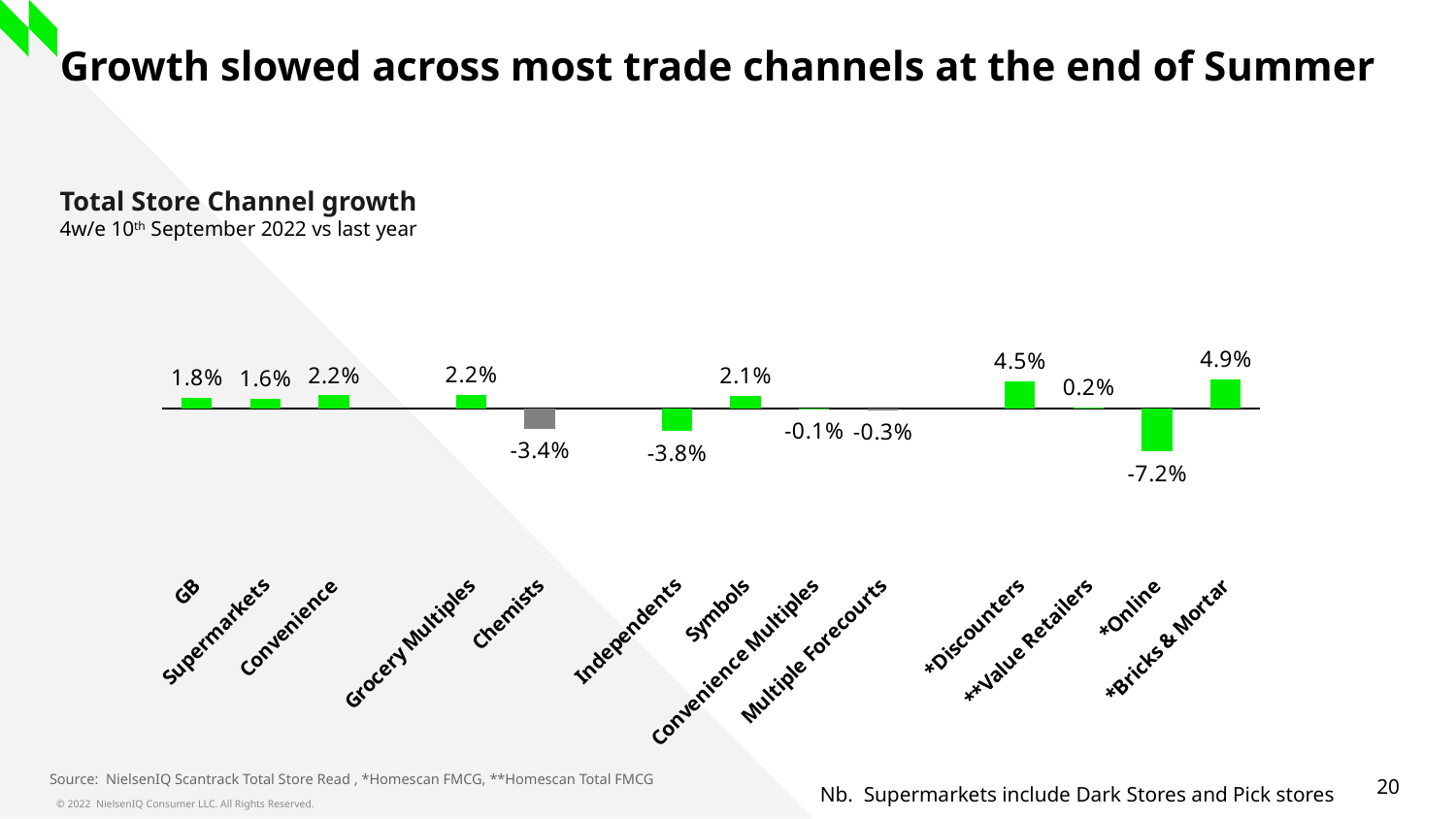
What is the difference in percentage points between the values for *Bricks & Mortar and *Discounters? 0.4 percentage points What kind of chart is shown on the slide? Bar chart Which has the larger growth value, GB or Symbols? Symbols How many channels are plotted on the chart? 13 What period does the chart subtitle say the data covers? 4w/e 10th September 2022 vs last year What is the growth value shown for *Discounters? 4.5% What is the growth value shown for Supermarkets? 1.6% Which channel has the highest growth value on the chart? *Bricks & Mortar What is the growth value shown for *Online? -7.2% Which has the larger growth value, Independents or Chemists? Chemists What is the growth value shown for Chemists? -3.4% Which channel has the lowest growth value on the chart? *Online